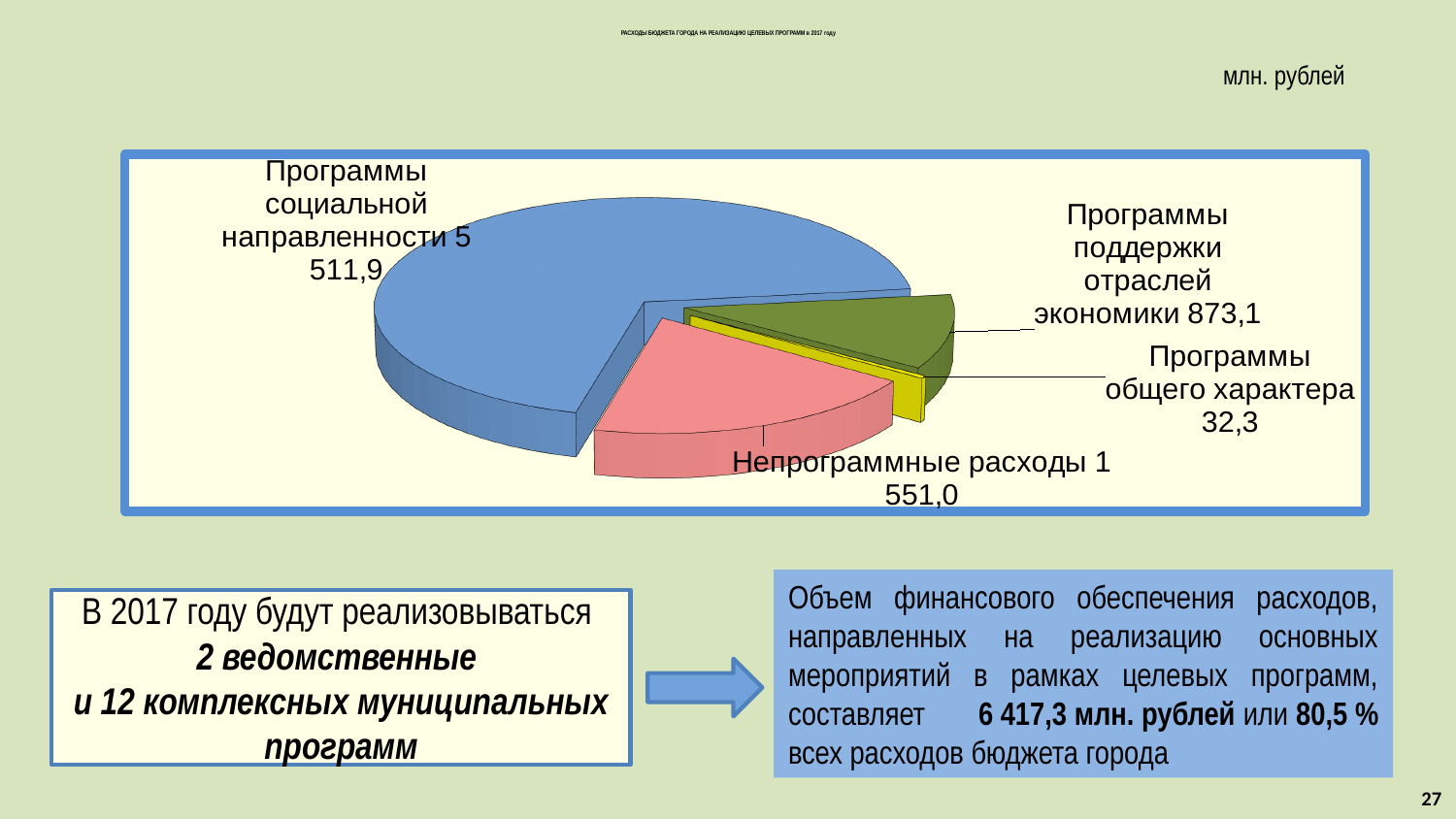
Which category has the smallest slice of the pie? Программы общего характера What is the difference between Программы социальной направленности and Непрограммные расходы? 3 960,9 Which is larger: Непрограммные расходы or Программы поддержки отраслей экономики? Непрограммные расходы What is the value for Программы поддержки отраслей экономики? 873,1 What kind of chart is shown on the slide? pie chart How many slices does the pie chart have? 4 Which category has the largest slice of the pie? Программы социальной направленности In what units are the values on the chart given? млн. рублей What is the value for Программы социальной направленности? 5 511,9 What is the value for Программы общего характера? 32,3 What is the difference between Программы поддержки отраслей экономики and Программы общего характера? 840,8 What is the value for Непрограммные расходы? 1 551,0